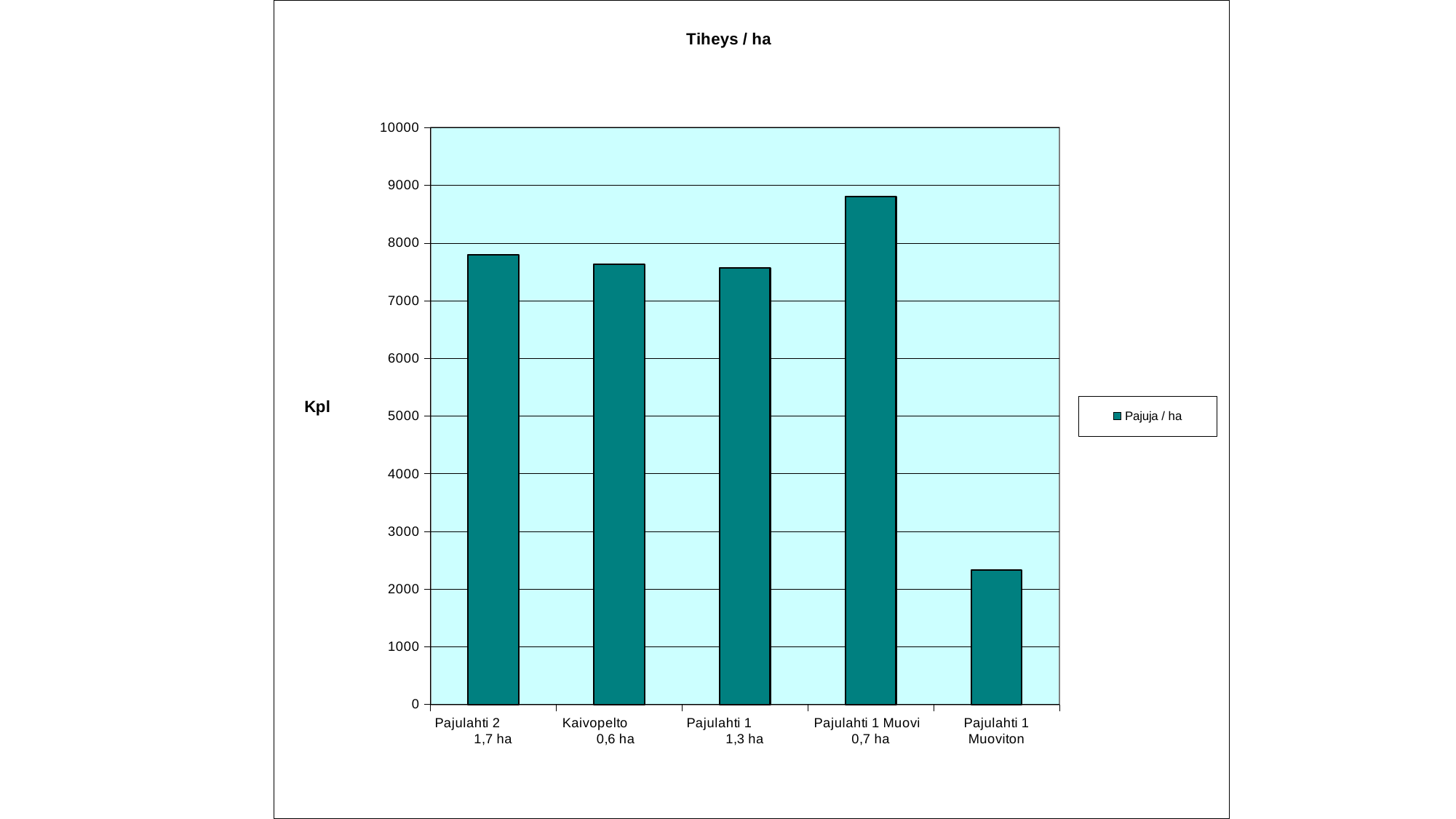
Is the value for Pajulahti 1 Muoviton greater or less than 3000? less Is the value for Kaivopelto 0,6 ha greater or less than 7000? greater What is the title of the chart? Tiheys / ha How many series does the legend list? 1 Is the value for Pajulahti 2 1,7 ha greater or less than 8000? less Which category has the lowest value? Pajulahti 1 Muoviton What kind of chart is shown on the slide? bar chart Which category has the highest value? Pajulahti 1 Muovi 0,7 ha What series name is shown in the legend? Pajuja / ha How many categories are shown on the x axis of the chart? 5 Which is larger, the value for Pajulahti 1 Muovi 0,7 ha or the value for Pajulahti 1 Muoviton? Pajulahti 1 Muovi 0,7 ha